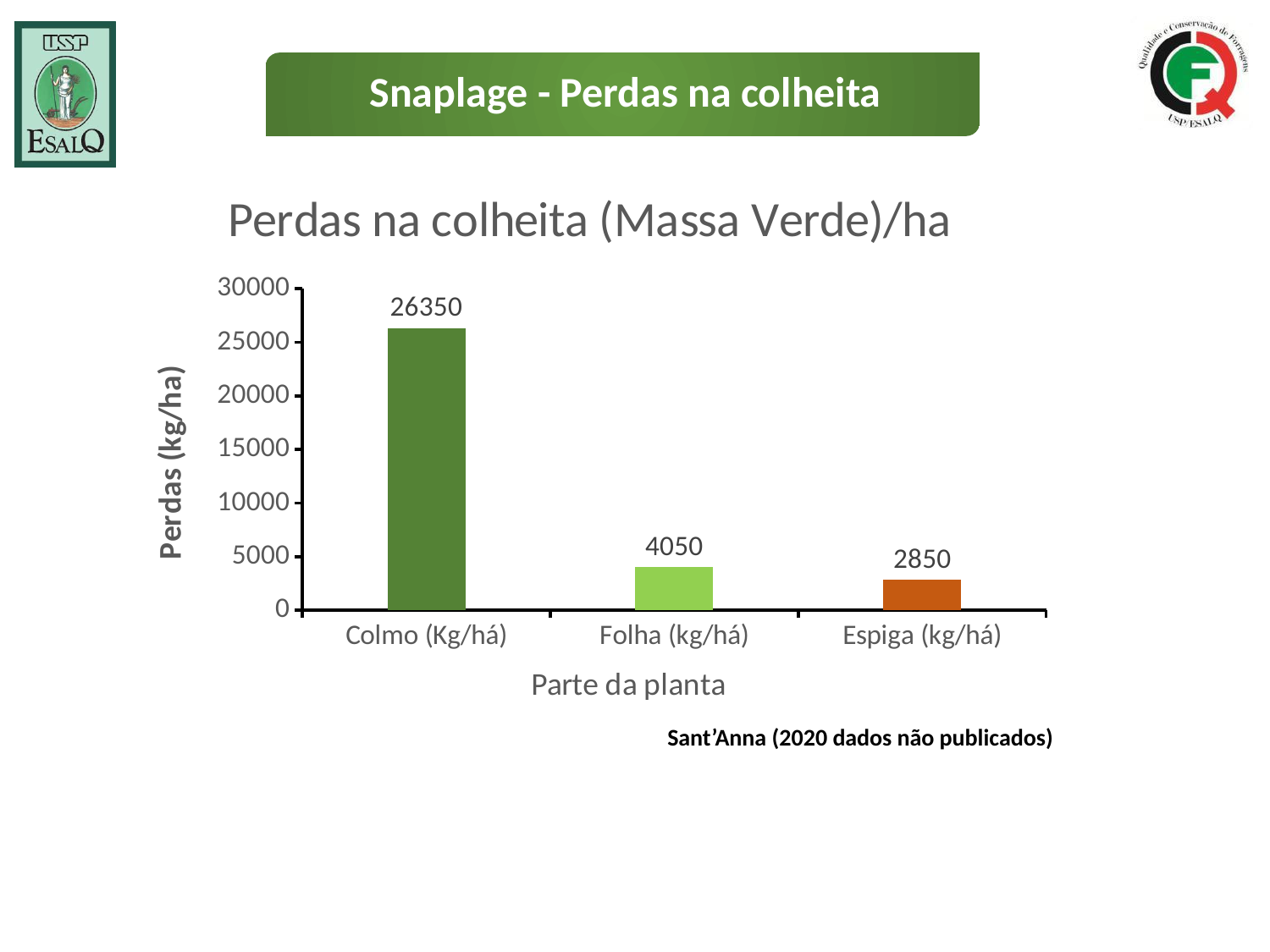
What is the value for Colmo (Kg/há)? 26350 What is the value for Folha (kg/há)? 4050 What is the value for Espiga (kg/há)? 2850 Which plant part has the lowest losses? Espiga (kg/há) What is the title of the chart? Perdas na colheita (Massa Verde)/ha Is the value for Colmo greater or less than 25000? greater Which is larger, the value for Folha or the value for Espiga? Folha (kg/há) Which plant part has the highest losses? Colmo (Kg/há) What is the difference between the values for Colmo and Folha? 22300 What kind of chart is shown? Bar chart How many plant parts are shown on the x axis? 3 What is the difference between the values for Folha and Espiga? 1200